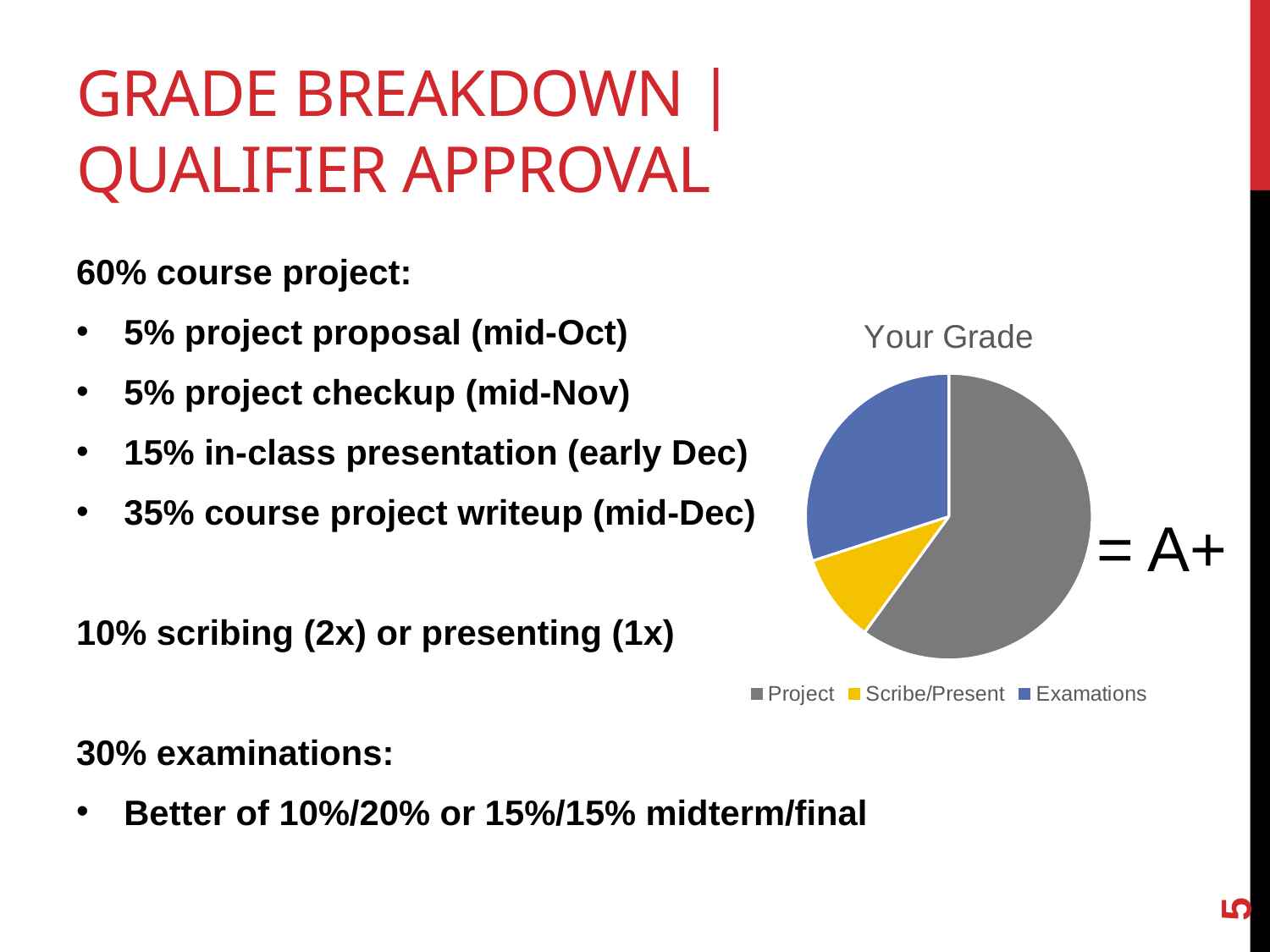
How many slices does the pie chart have? 3 Which slice is larger, Examations or Scribe/Present? Examations What is the title of the chart? Your Grade How many entries does the chart's legend list? 3 What kind of chart is shown on the slide? pie chart Which category has the smallest slice of the pie? Scribe/Present What colour is the Project slice in the pie chart? grey Which slice is larger, Project or Examations? Project Which category has the largest slice of the pie? Project